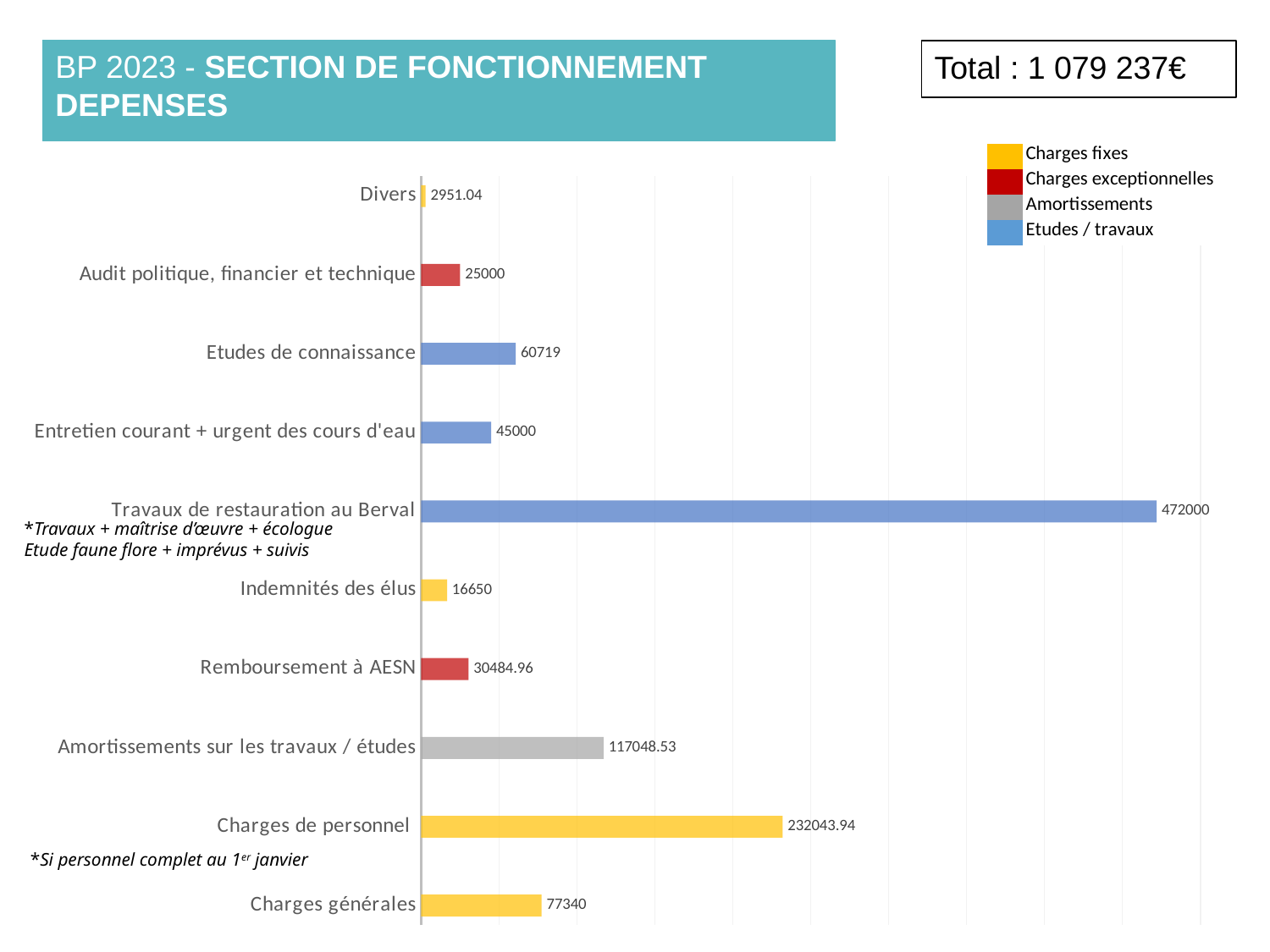
What is the value for Amortissements sur les travaux / études? 117048.53 What kind of chart is shown on the slide? Bar chart Which category has the highest value? Travaux de restauration au Berval What is the value for Travaux de restauration au Berval? 472000 What is the value for Remboursement à AESN? 30484.96 What is the difference between Etudes de connaissance and Entretien courant + urgent des cours d'eau? 15719 How many categories are shown in the chart? 10 Which category has the lowest value? Divers How many entries does the legend list? 4 What is the value for Charges de personnel? 232043.94 What is the difference between Charges générales and Audit politique, financier et technique? 52340 Which is larger, Indemnités des élus or Audit politique, financier et technique? Audit politique, financier et technique